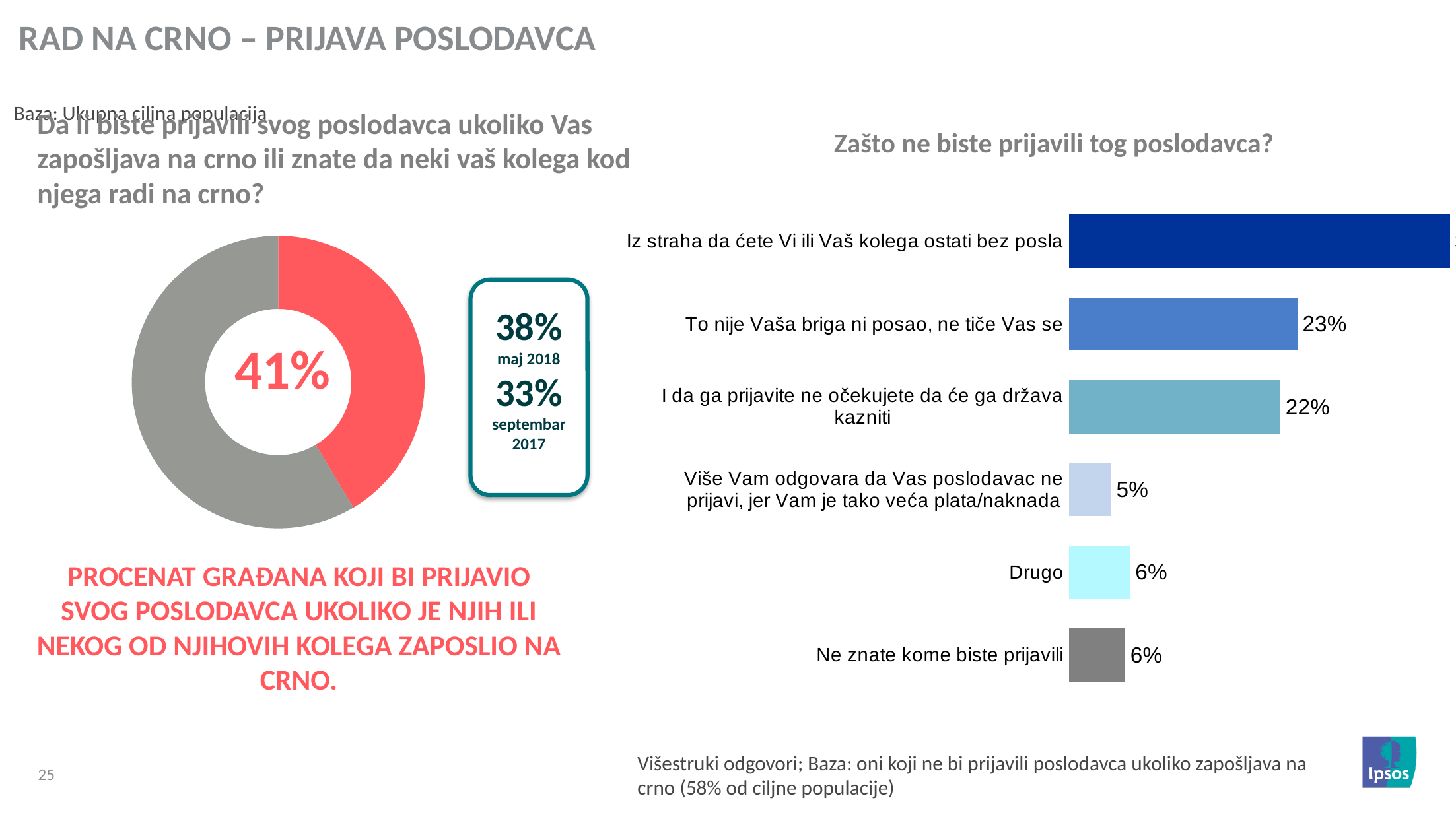
In the chart 'Zašto ne biste prijavili tog poslodavca?', what is the difference between 'To nije Vaša briga ni posao, ne tiče Vas se' and 'I da ga prijavite ne očekujete da će ga država kazniti'? 1 percentage point In the chart 'Zašto ne biste prijavili tog poslodavca?', what is the value for 'Ne znate kome biste prijavili'? 6% In the chart 'Zašto ne biste prijavili tog poslodavca?', which category has the lowest value? Više Vam odgovara da Vas poslodavac ne prijavi, jer Vam je tako veća plata/naknada In the donut chart on the left, what percentage is shown in the centre? 41% In the chart 'Zašto ne biste prijavili tog poslodavca?', which category has the longest bar? Iz straha da ćete Vi ili Vaš kolega ostati bez posla What kind of chart is the chart on the left of the slide? Donut (pie) chart How many categories are shown in the chart 'Zašto ne biste prijavili tog poslodavca?'? 6 In the chart 'Zašto ne biste prijavili tog poslodavca?', what is the value for 'I da ga prijavite ne očekujete da će ga država kazniti'? 22% In the chart 'Zašto ne biste prijavili tog poslodavca?', what is the value for 'Više Vam odgovara da Vas poslodavac ne prijavi, jer Vam je tako veća plata/naknada'? 5% How many slices does the donut chart on the left have? 2 What kind of chart is the chart titled 'Zašto ne biste prijavili tog poslodavca?'? Bar chart In the chart 'Zašto ne biste prijavili tog poslodavca?', what is the value for 'To nije Vaša briga ni posao, ne tiče Vas se'? 23%